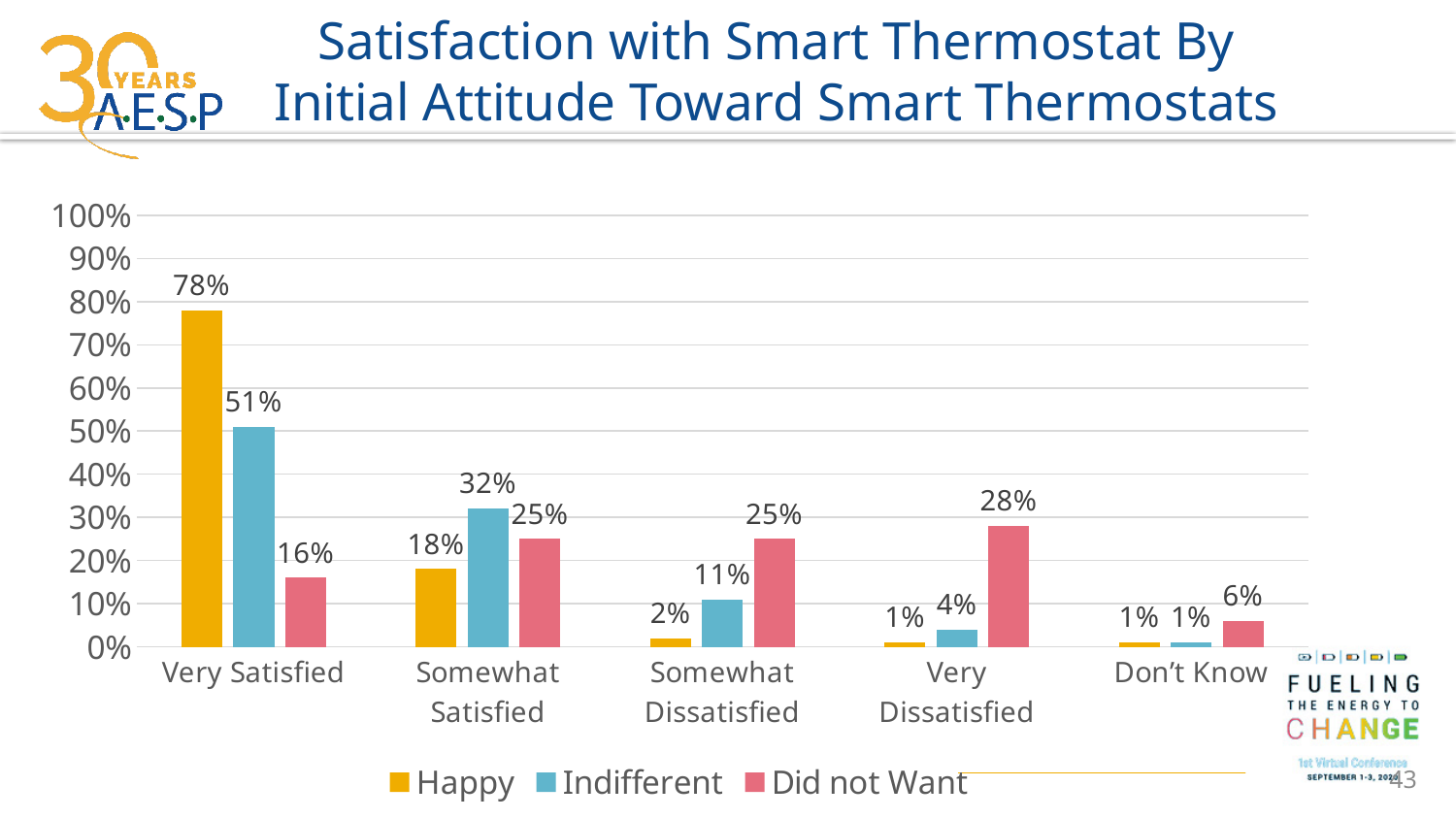
What is the difference between the Happy and Indifferent values in the Very Satisfied category? 27% What is the value for Happy in the Very Satisfied category? 78% How many categories are shown on the x axis? 5 Which category has the highest value for the Happy series? Very Satisfied Is the value for Happy in the Very Satisfied category greater or less than 70%? greater What is the value for Did not Want in the Very Dissatisfied category? 28% What kind of chart is shown on the slide? Bar chart How many series does the legend list? 3 What is the value for Indifferent in the Somewhat Satisfied category? 32% In the Somewhat Dissatisfied category, which is larger: Indifferent or Did not Want? Did not Want Which series is shown in yellow? Happy Which category has the lowest value for the Did not Want series? Don't Know